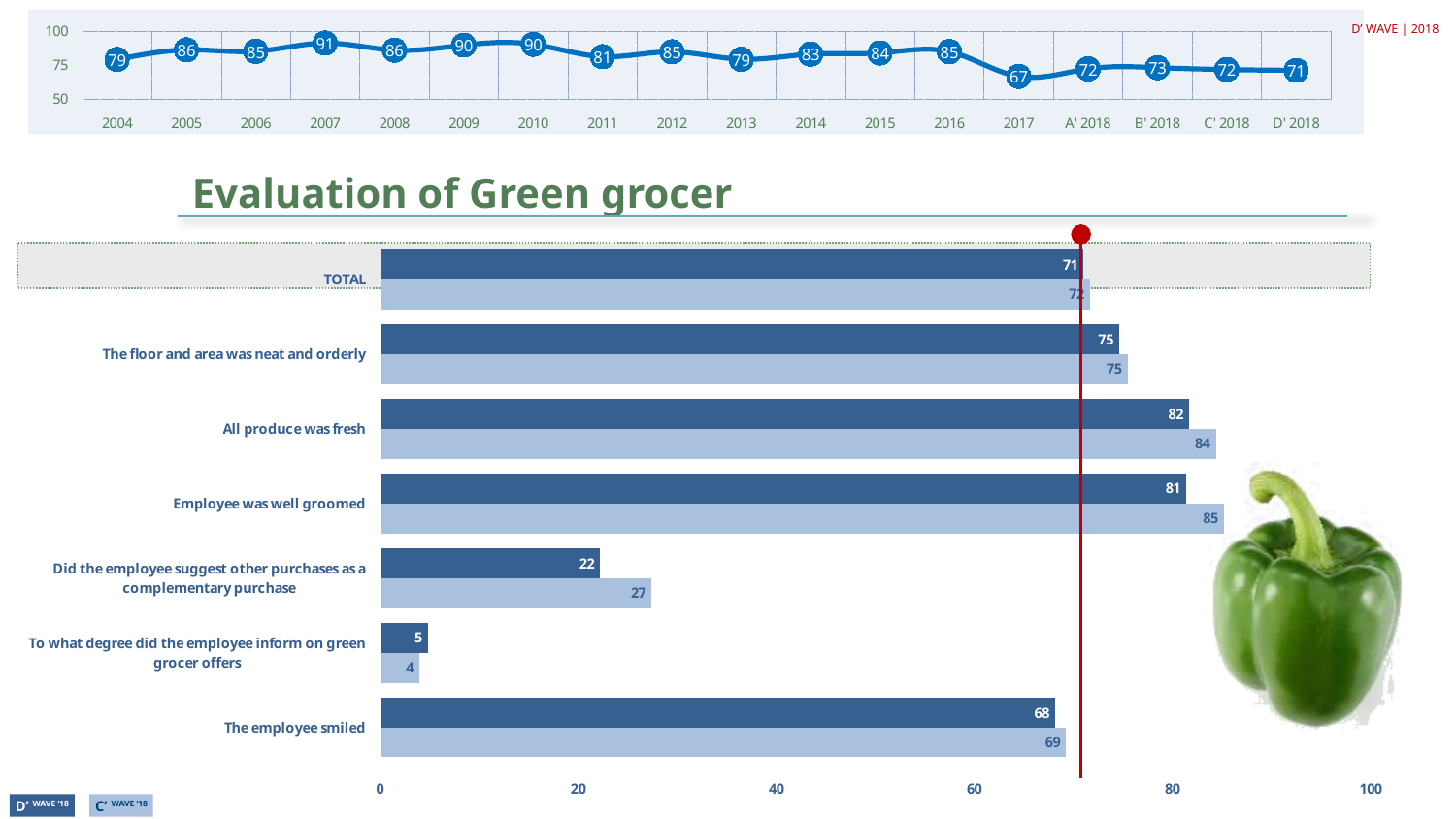
In the line chart at the top of the slide, what is the value for 2007? 91 In the 'Evaluation of Green grocer' chart, how many series does the legend list? 2 What type of chart is the 'Evaluation of Green grocer' chart? Bar chart In the 'Evaluation of Green grocer' chart, what is the D' WAVE '18 value for 'All produce was fresh'? 82 In the 'Evaluation of Green grocer' chart, which category has the lowest D' WAVE '18 value? To what degree did the employee inform on green grocer offers In the line chart at the top of the slide, what is the difference between the values for 2016 and 2017? 18 In the line chart at the top of the slide, which year has the highest value? 2007 In the 'Evaluation of Green grocer' chart, what is the difference between the C' WAVE '18 and D' WAVE '18 values for 'Did the employee suggest other purchases as a complementary purchase'? 5 In the line chart at the top of the slide, how many data points are plotted? 18 In the 'Evaluation of Green grocer' chart, what is the C' WAVE '18 value for 'Employee was well groomed'? 85 In the 'Evaluation of Green grocer' chart, which category has the highest D' WAVE '18 value? All produce was fresh In the line chart at the top of the slide, which year has the lowest value? 2017